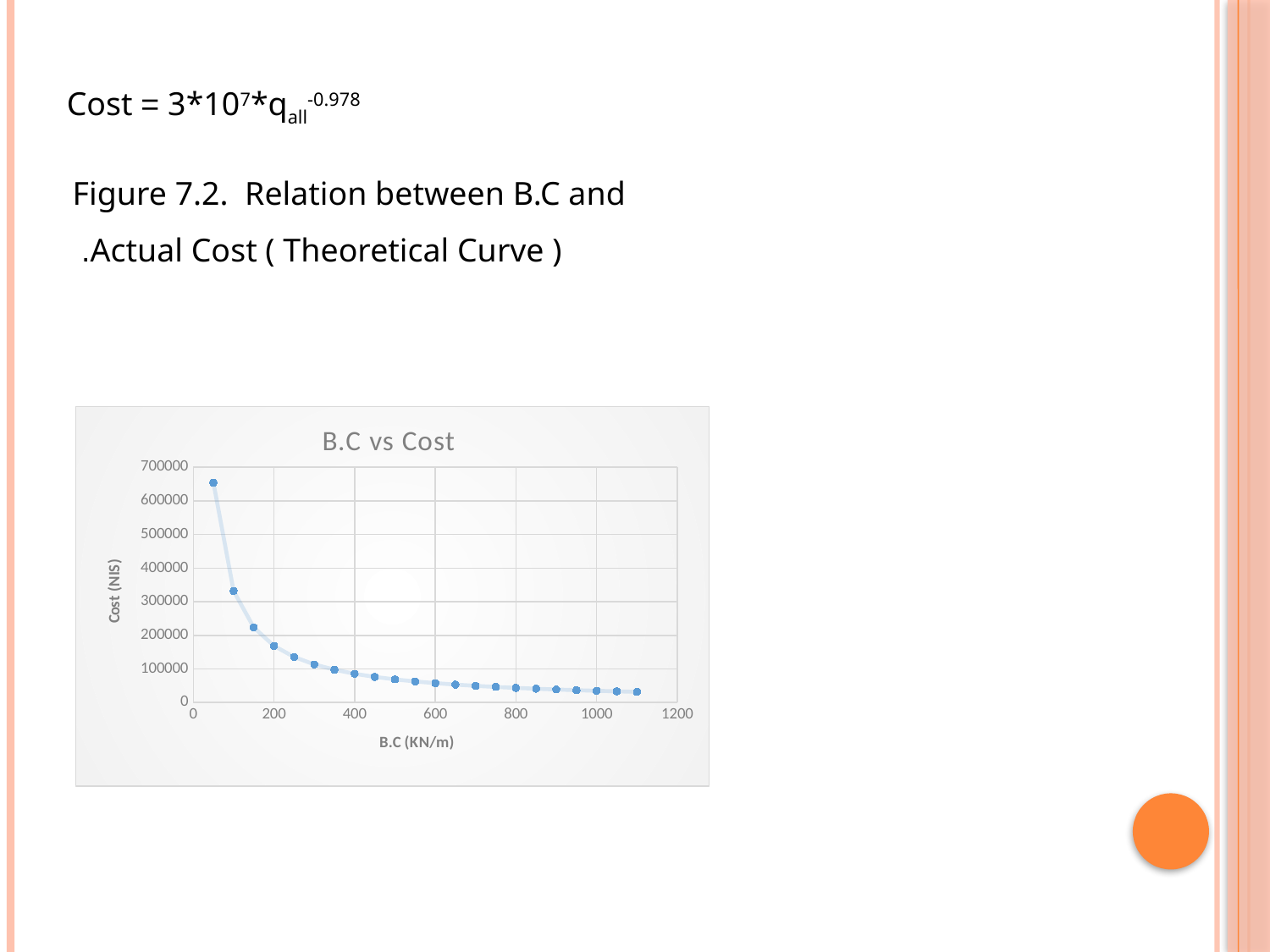
Is the cost at B.C = 400 KN/m greater or less than 100000? less Which has the larger cost, B.C = 100 or B.C = 200? B.C = 100 Is the cost at B.C = 200 KN/m greater or less than 200000? less Is the cost at B.C = 50 KN/m greater or less than 600000? greater Do the cost values rise or fall as B.C increases along the x axis? fall What is the label of the y axis? Cost (NIS) How many data points are plotted on the chart? 22 What kind of chart is shown on the slide? scatter chart with a smooth line What is the title of the chart? B.C vs Cost